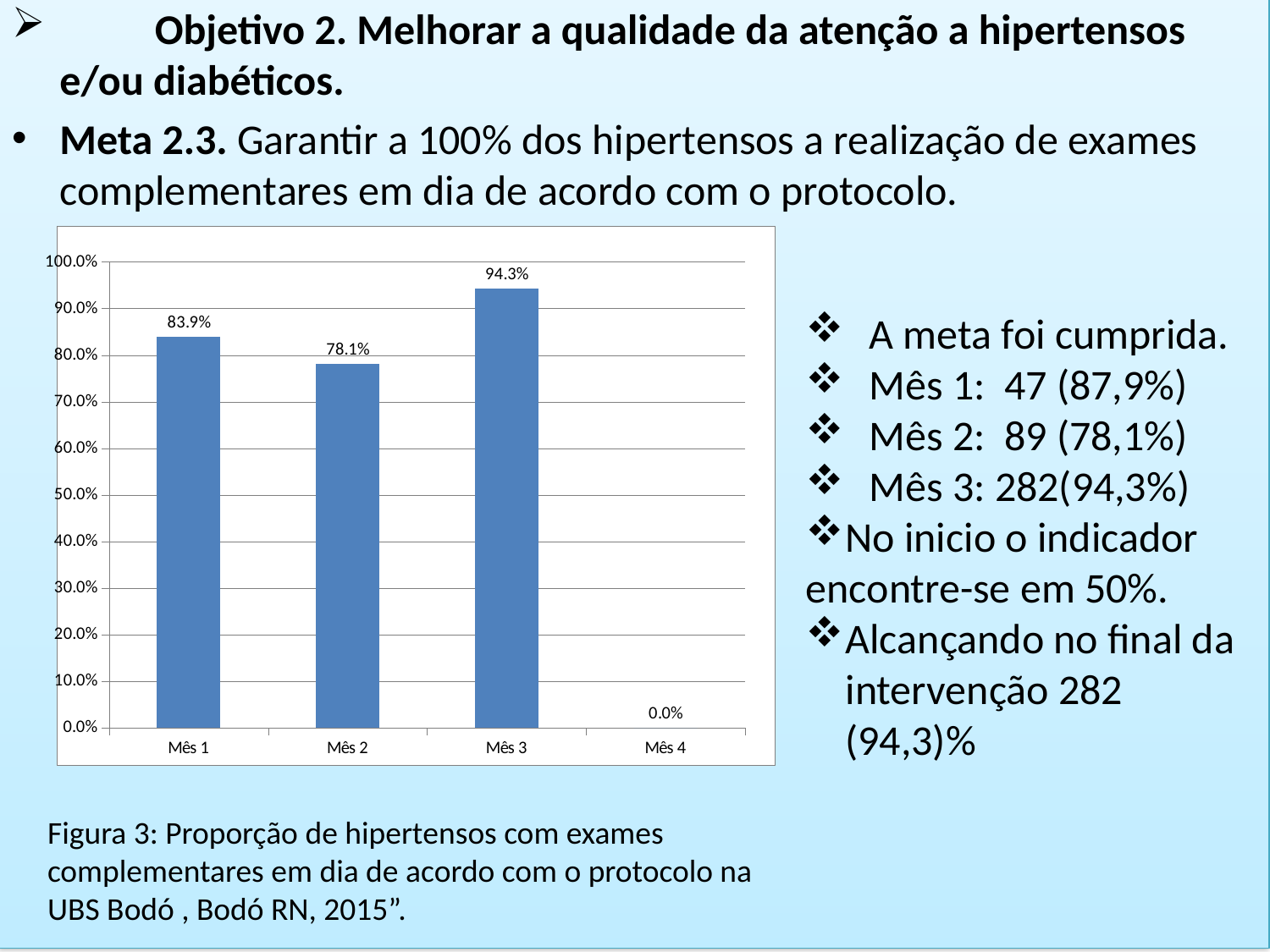
Which month has the highest value? Mês 3 What is the difference between the values for Mês 1 and Mês 2? 5.8% What is the value for Mês 2? 78.1% Which is larger, the value for Mês 1 or the value for Mês 2? Mês 1 What is the value for Mês 4? 0.0% How many categories are shown on the x axis? 4 What is the difference between the values for Mês 3 and Mês 2? 16.2% What kind of chart is shown on the slide? bar chart Which month has the lowest value? Mês 4 Is the value for Mês 3 greater or less than 90.0%? greater What is the value for Mês 1? 83.9% What is the value for Mês 3? 94.3%